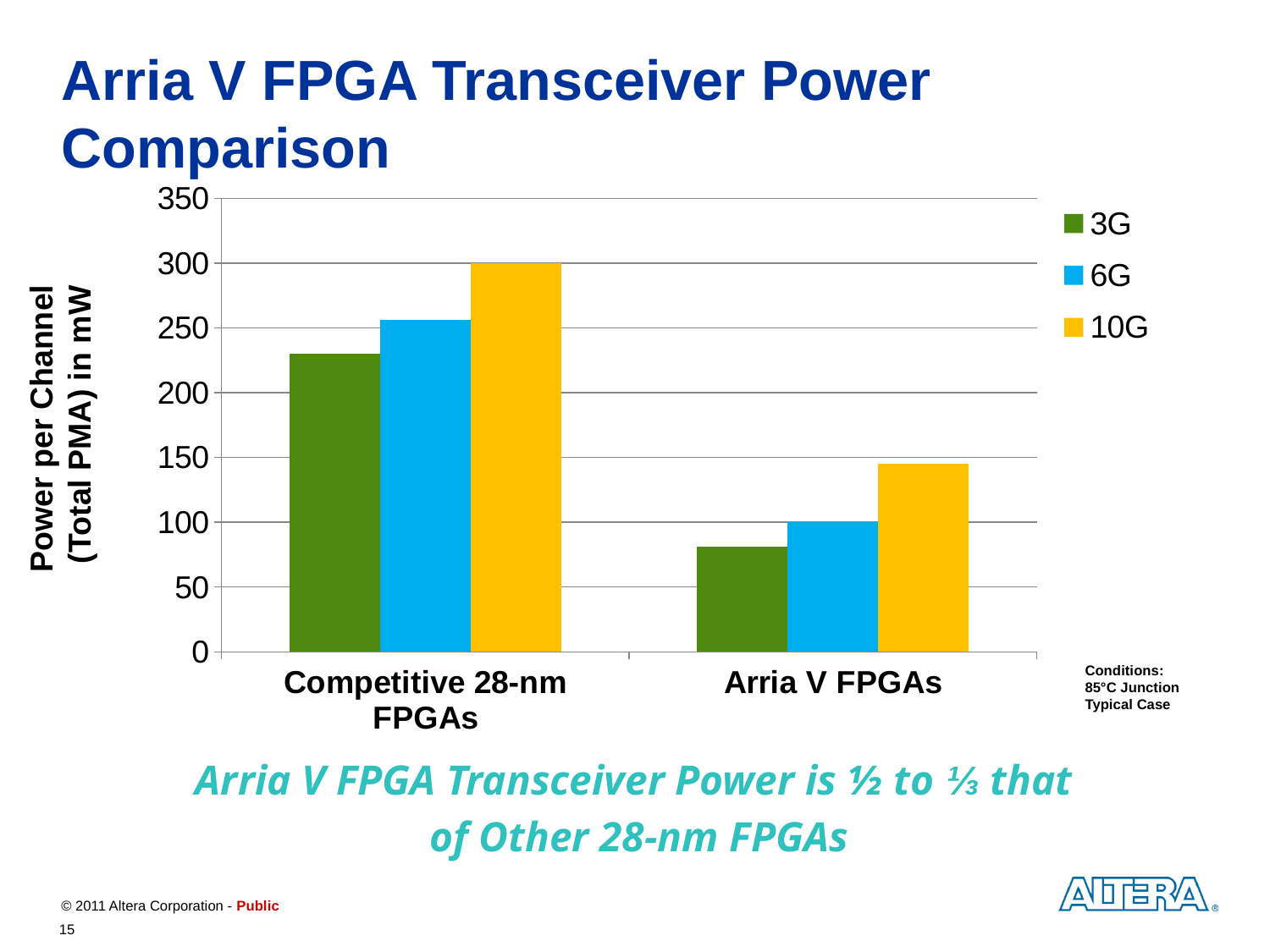
What kind of chart is shown on the slide? bar chart Which series and category has the highest bar? 10G for Competitive 28-nm FPGAs What is the label of the y axis? Power per Channel (Total PMA) in mW Is the 3G value for Competitive 28-nm FPGAs greater or less than 200? greater How many categories are shown on the x axis? 2 What is the 10G value for Competitive 28-nm FPGAs? 300 Is the 3G value for Arria V FPGAs greater or less than 100? less How many series does the legend list? 3 What is the 6G value for Arria V FPGAs? 100 Which is larger, the 6G value for Competitive 28-nm FPGAs or the 6G value for Arria V FPGAs? Competitive 28-nm FPGAs Which series and category has the lowest bar? 3G for Arria V FPGAs